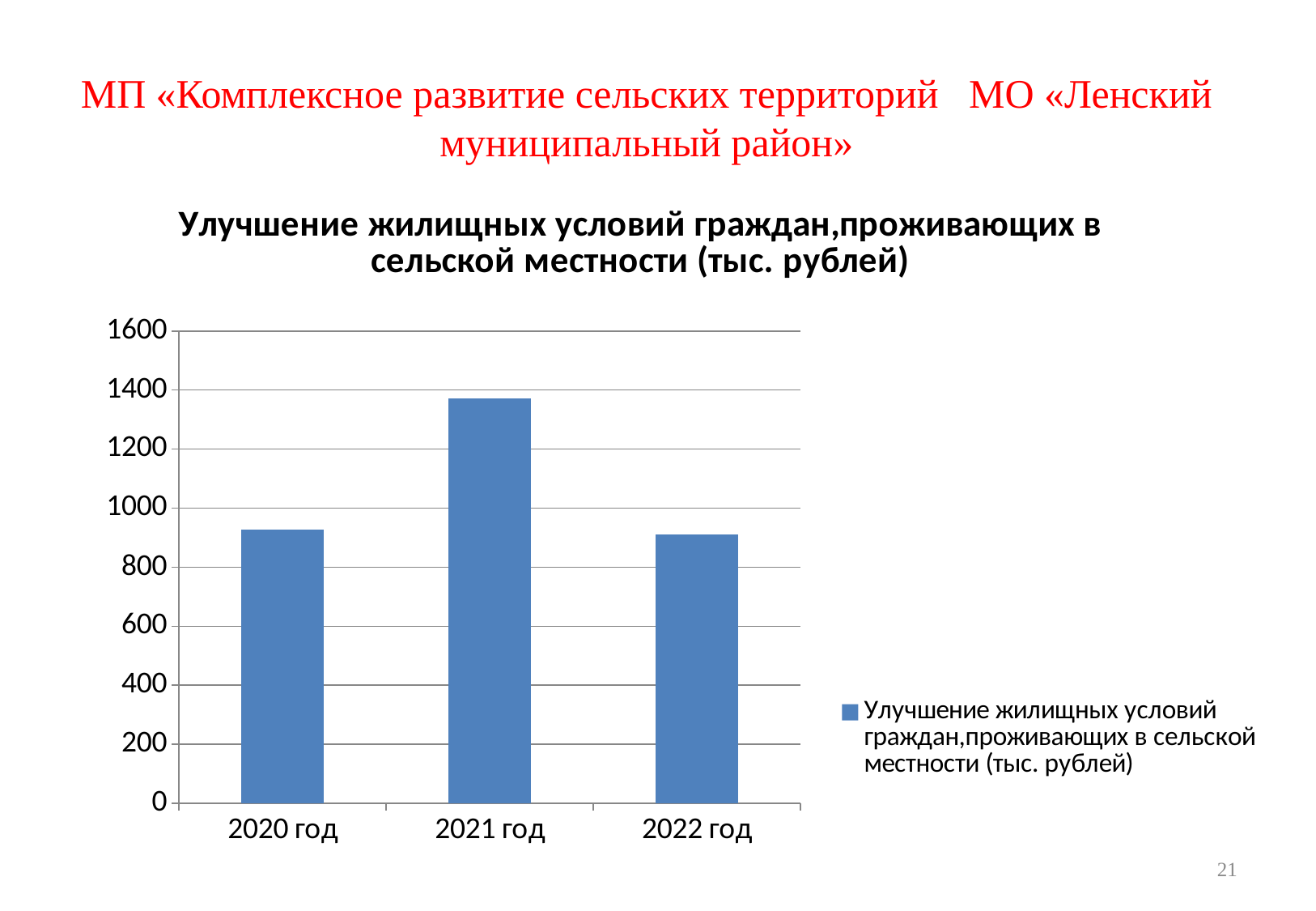
Is the value for 2021 год greater or less than 1200? greater Which is larger, the value for 2021 год or the value for 2022 год? 2021 год Is the value for 2021 год greater or less than 1400? less How many series does the legend of the chart list? 1 What is the highest value shown on the vertical axis of the chart? 1600 Which year has the highest value in the chart? 2021 год Is the value for 2022 год greater or less than 1000? less What kind of chart is shown on the slide? bar chart What is the title of the chart? Улучшение жилищных условий граждан,проживающих в сельской местности (тыс. рублей) How many categories (years) are shown on the x axis of the chart? 3